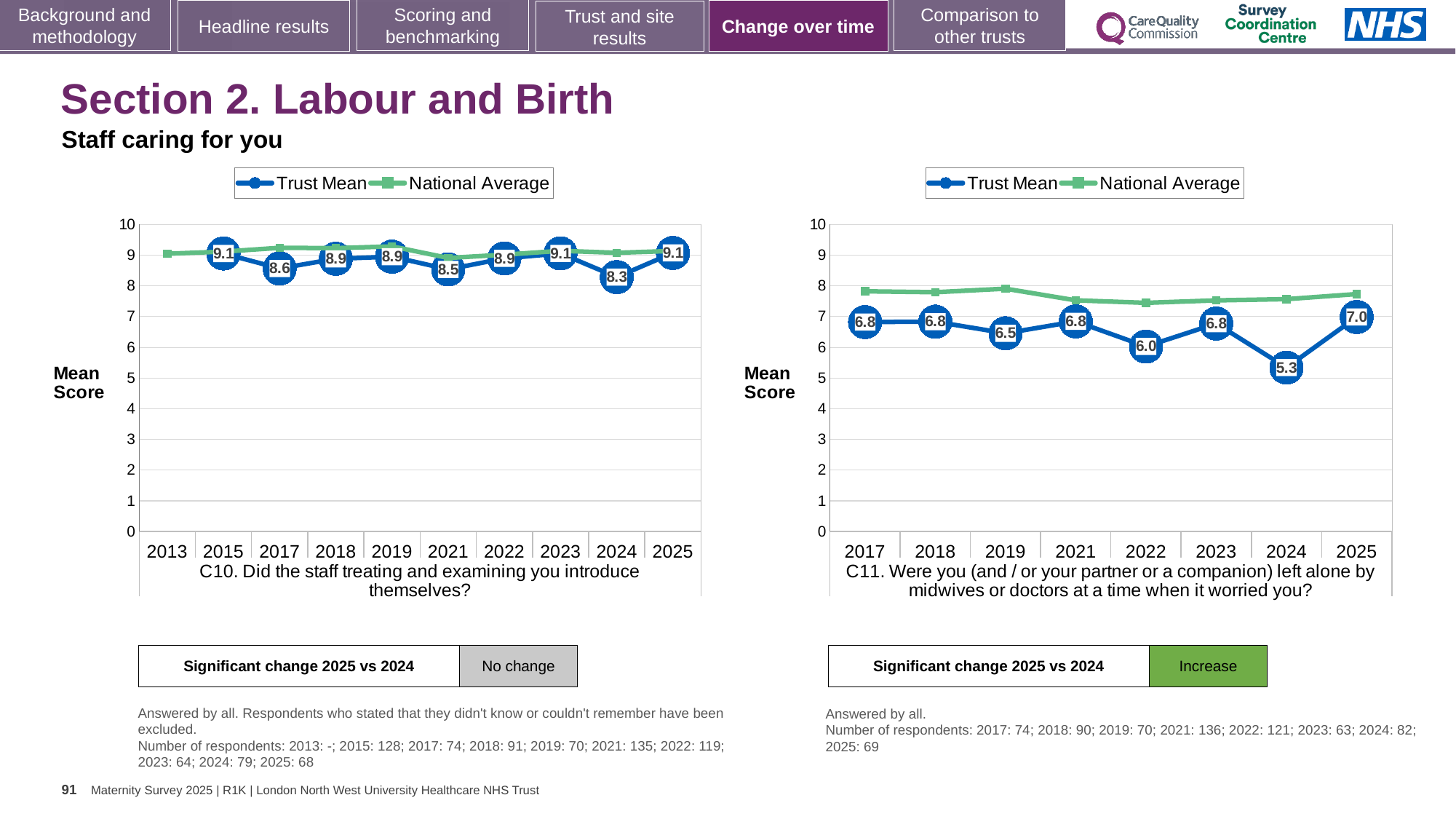
In the C11 chart, what is the Trust Mean score for 2022? 6.0 In the C10 chart, which year has the lowest Trust Mean score? 2024 In the C10 chart, what is the Trust Mean score for 2024? 8.3 In the C10 chart, what is the Trust Mean score for 2021? 8.5 How many years are shown on the x axis of the C11 chart? 8 In the C10 chart, is the Trust Mean score for 2023 larger or smaller than the score for 2017? larger In the C11 chart, what is the difference between the Trust Mean scores for 2025 and 2024? 1.7 What kind of chart is the C10 chart? line chart In the C11 chart, which year has the lowest Trust Mean score? 2024 In the C11 chart, is the National Average value for 2017 greater or less than 7? greater In the C11 chart, what is the Trust Mean score for 2025? 7.0 In the C11 chart, which year has the highest Trust Mean score? 2025